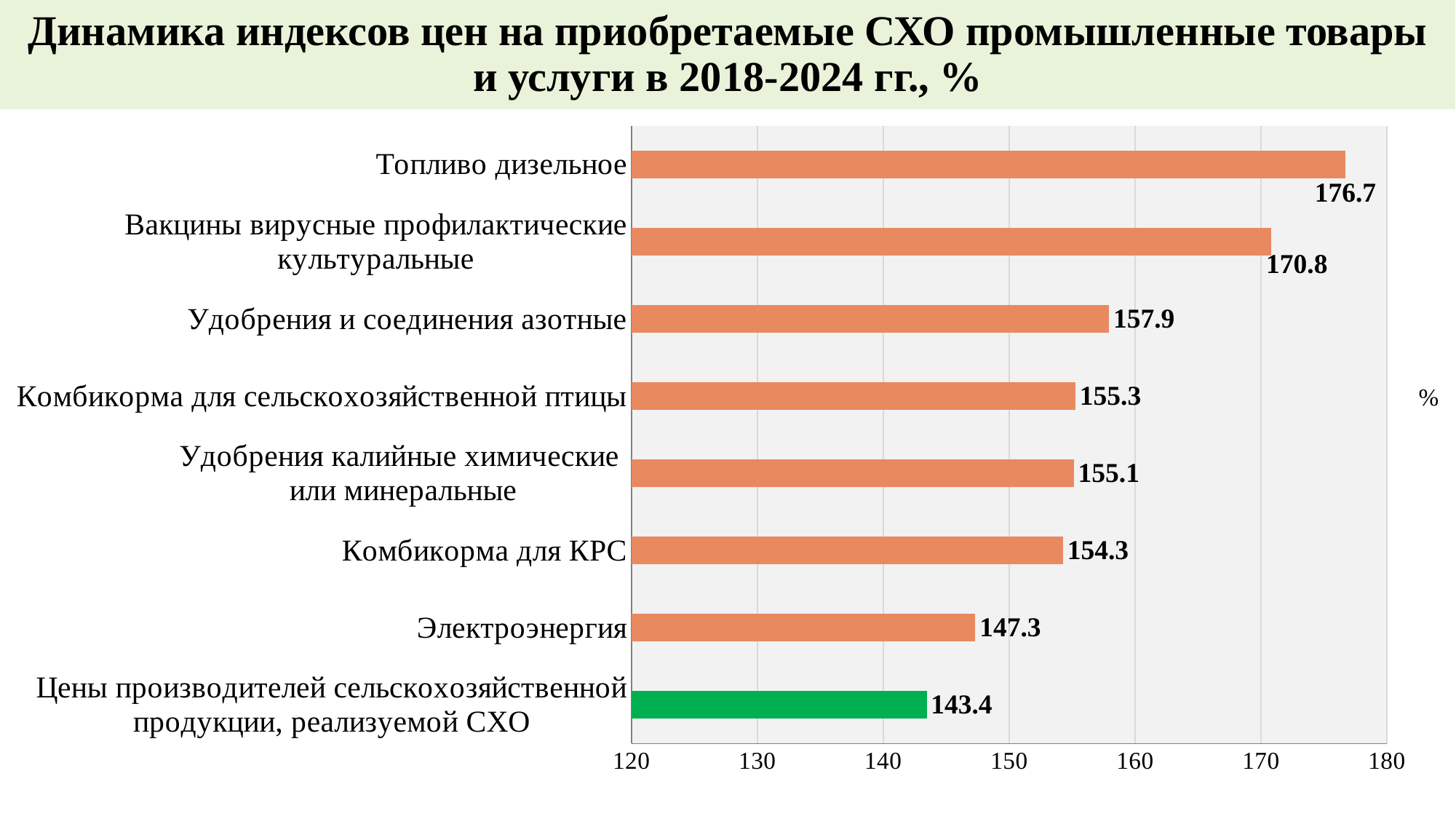
Which category has the lowest value? Цены производителей сельскохозяйственной продукции, реализуемой СХО Which bar is coloured green rather than orange? Цены производителей сельскохозяйственной продукции, реализуемой СХО What is the value for Цены производителей сельскохозяйственной продукции, реализуемой СХО? 143.4 What is the value for Топливо дизельное? 176.7 What is the difference between the values for Удобрения и соединения азотные and Электроэнергия? 10.6 What is the value for Комбикорма для КРС? 154.3 What is the difference between the values for Топливо дизельное and Вакцины вирусные профилактические культуральные? 5.9 Which is larger: the value for Комбикорма для сельскохозяйственной птицы or the value for Комбикорма для КРС? Комбикорма для сельскохозяйственной птицы How many categories are shown in the chart? 8 Which category has the highest value? Топливо дизельное What kind of chart is shown on the slide? bar chart What is the value for Электроэнергия? 147.3